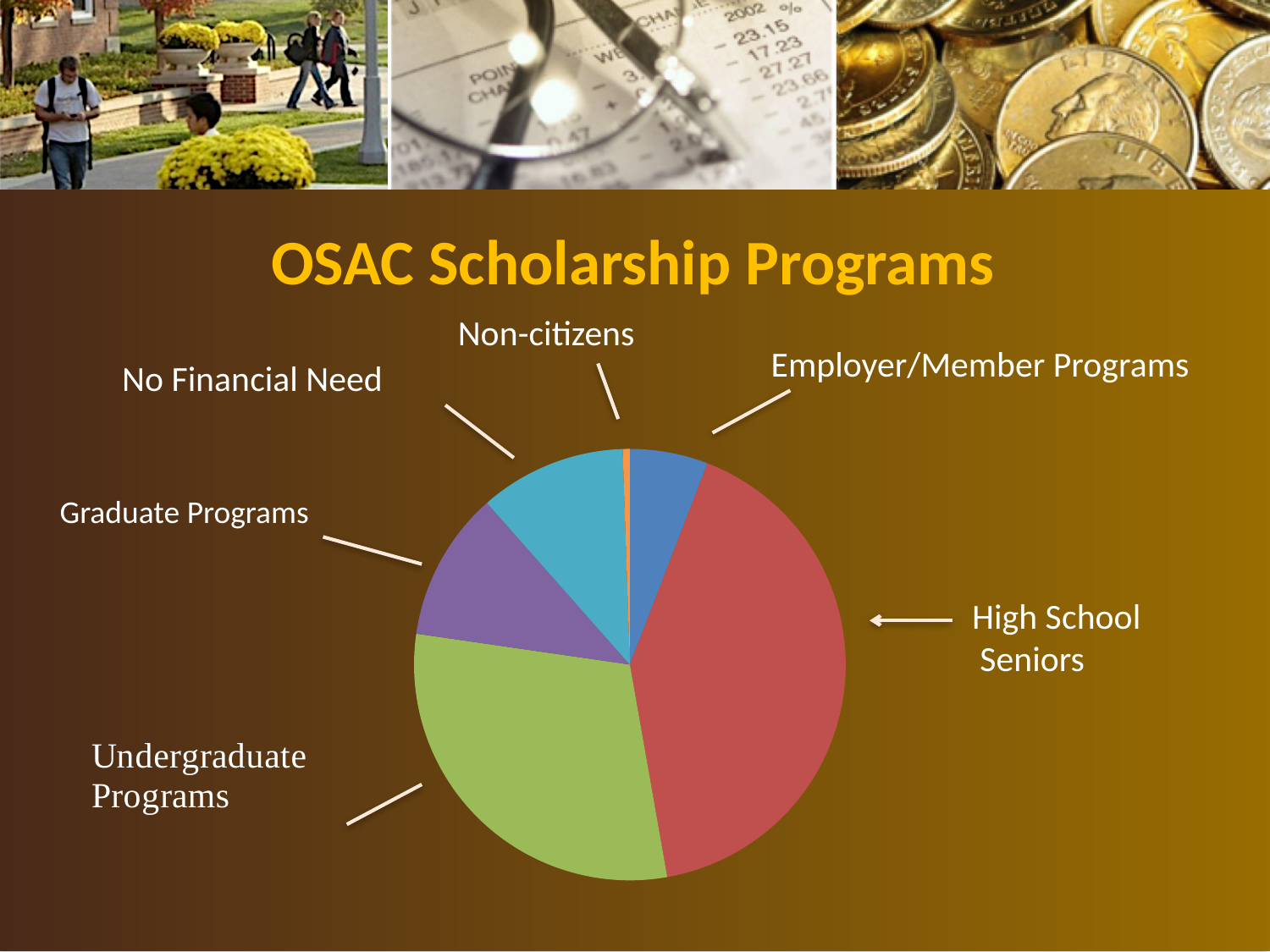
What kind of chart is shown on the slide? pie chart What is the title of the chart? OSAC Scholarship Programs Which slice is larger, Undergraduate Programs or No Financial Need? Undergraduate Programs Which slice is larger, High School Seniors or Undergraduate Programs? High School Seniors Which category has the smallest slice of the pie? Non-citizens What colour is the High School Seniors slice? red Which slice is larger, Undergraduate Programs or Graduate Programs? Undergraduate Programs How many slices does the pie chart have? 6 Which category has the largest slice of the pie? High School Seniors